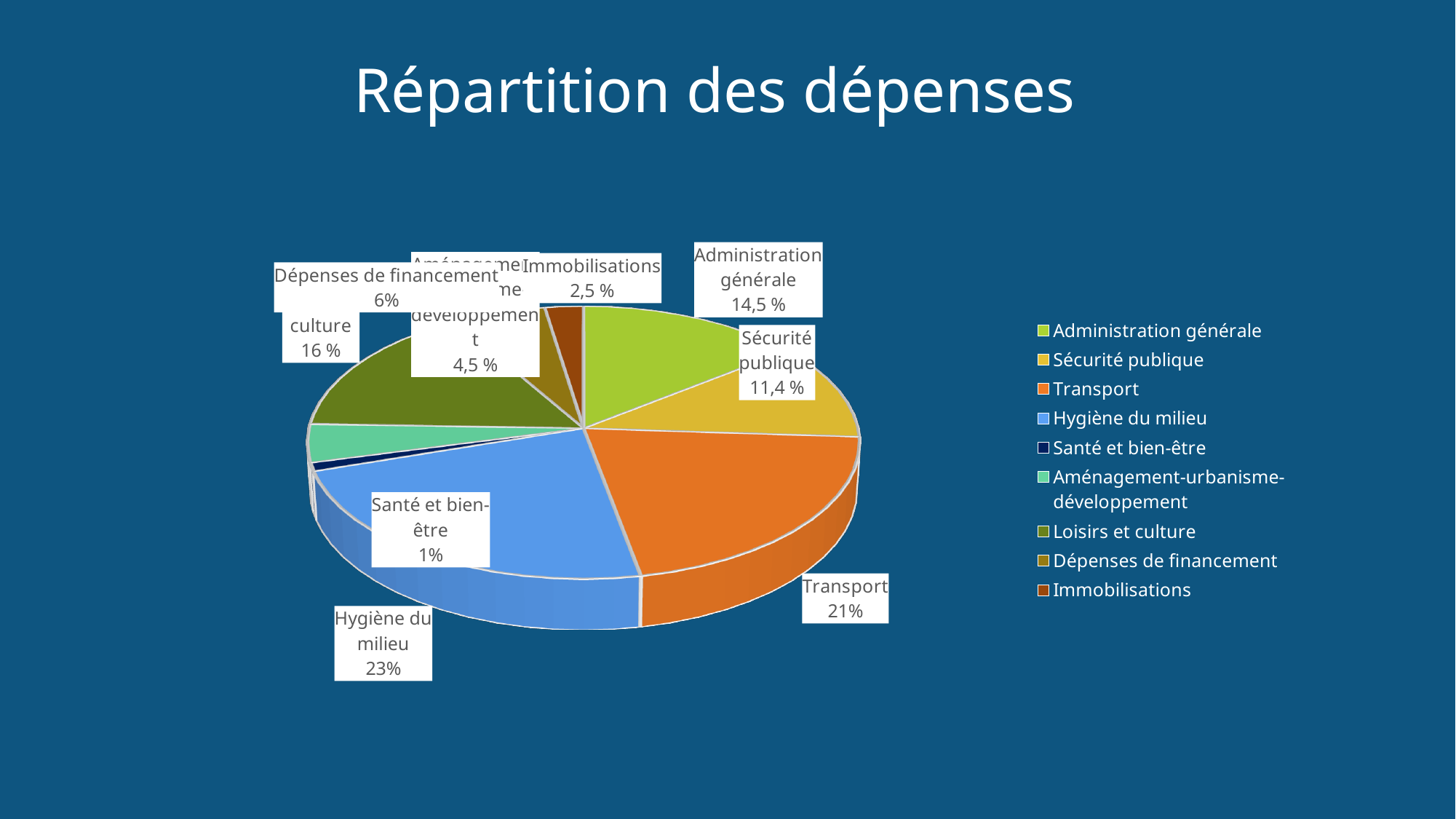
What share of expenses goes to Hygiène du milieu? 23% How many categories does the legend list? 9 What kind of chart is shown on the slide? Pie chart Which has a larger share, Loisirs et culture or Dépenses de financement? Loisirs et culture What is the title of the chart? Répartition des dépenses By how many percentage points does the share for Hygiène du milieu exceed the share for Transport? 2 Which category has the largest share of expenses? Hygiène du milieu What share of expenses goes to Administration générale? 14,5 % What share of expenses goes to Transport? 21% What share of expenses goes to Immobilisations? 2,5 % What share of expenses goes to Sécurité publique? 11,4 % Which category has the smallest share of expenses? Santé et bien-être